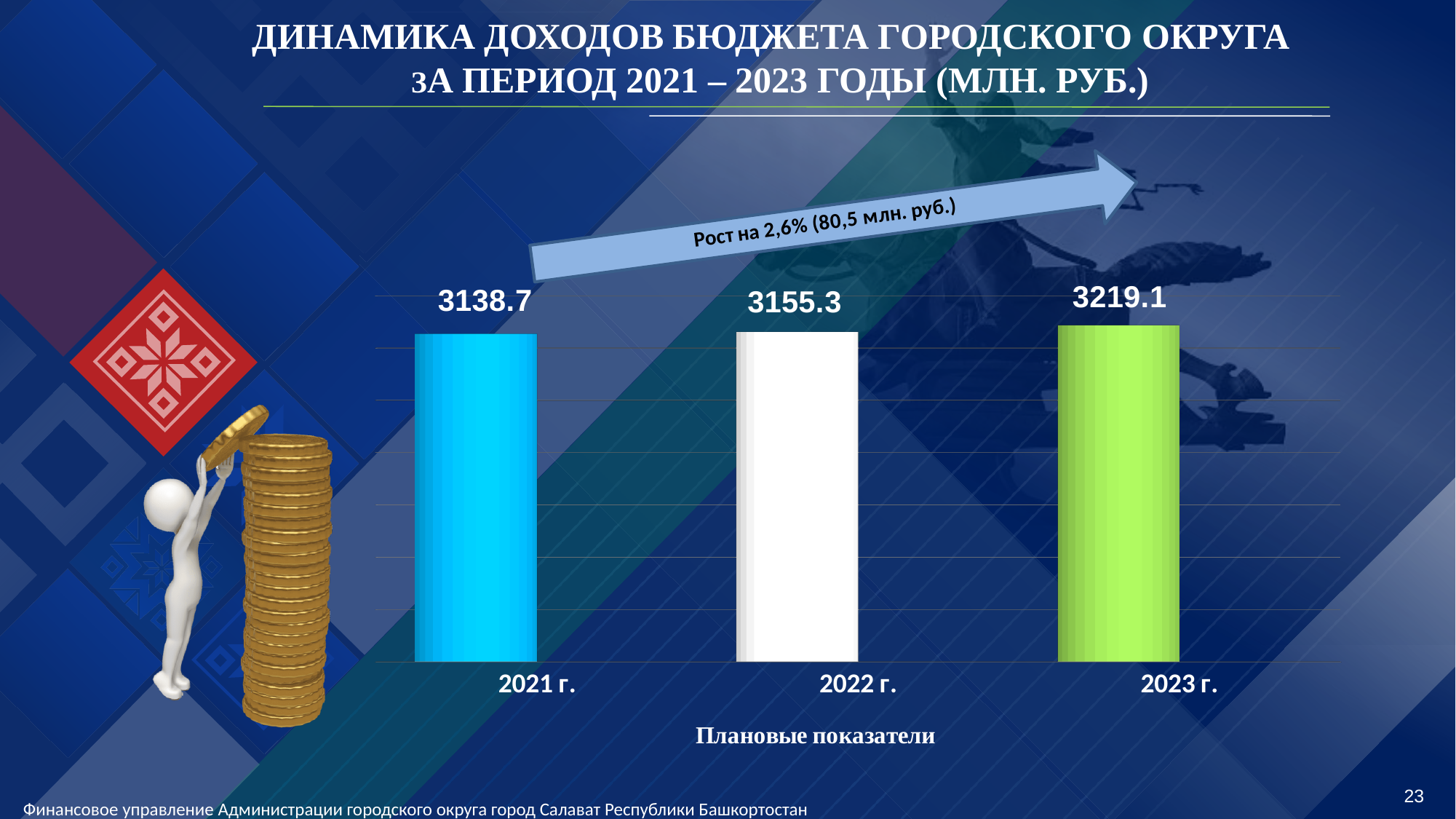
What growth does the arrow above the bars state? Рост на 2,6% (80,5 млн. руб.) How many bars are shown in the chart? 3 What is the value for 2023 г.? 3219.1 What is the value for 2021 г.? 3138.7 Which year has the lowest value? 2021 г. Do the values rise or fall from 2021 г. to 2023 г.? Rise What kind of chart is shown on the slide? Bar chart Which year has the highest value? 2023 г. Which is larger, the value for 2022 г. or the value for 2021 г.? 2022 г. What is the difference between the values for 2023 г. and 2021 г.? 80.4 What is the value for 2022 г.? 3155.3 What is the difference between the values for 2022 г. and 2021 г.? 16.6